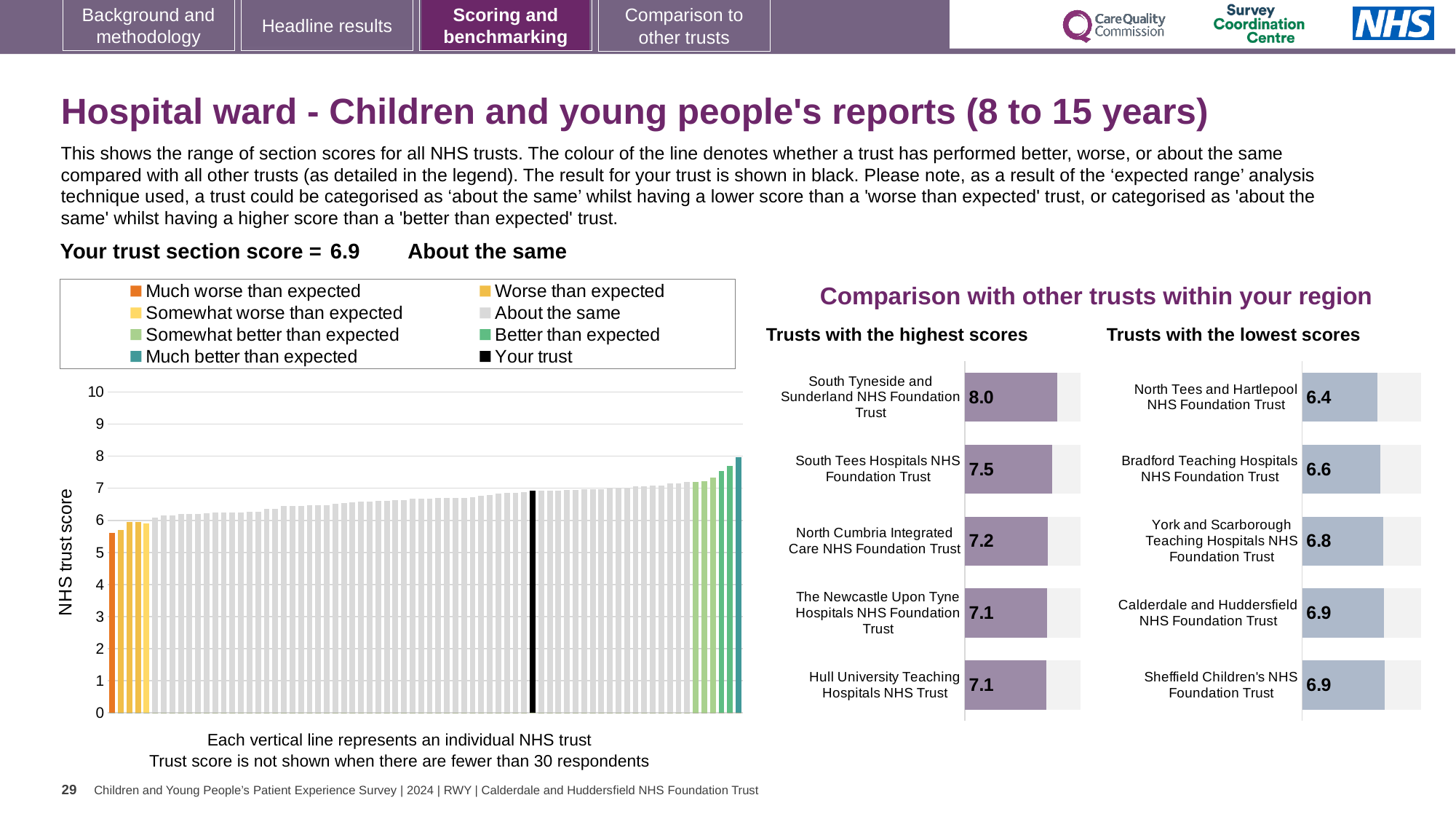
In the 'Trusts with the lowest scores' chart, which trust has the lowest score? North Tees and Hartlepool NHS Foundation Trust What kind of chart is the large chart on the left showing NHS trust scores? Bar chart In the 'Trusts with the lowest scores' chart, what is the score for Bradford Teaching Hospitals NHS Foundation Trust? 6.6 In the 'Trusts with the lowest scores' chart, which has the larger score: Bradford Teaching Hospitals NHS Foundation Trust or York and Scarborough Teaching Hospitals NHS Foundation Trust? York and Scarborough Teaching Hospitals NHS Foundation Trust In the 'Trusts with the highest scores' chart, what is the score for South Tyneside and Sunderland NHS Foundation Trust? 8.0 In the large chart on the left, is the value of the tallest bar greater or less than 7? greater In the 'Trusts with the highest scores' chart, what is the score for North Cumbria Integrated Care NHS Foundation Trust? 7.2 How many entries does the legend of the large chart on the left list? 8 In the 'Trusts with the highest scores' chart, which trust has the highest score? South Tyneside and Sunderland NHS Foundation Trust In the large chart on the left, do the bar values rise or fall from left to right along the x axis? Rise In the 'Trusts with the highest scores' chart, what is the difference between the scores of South Tyneside and Sunderland NHS Foundation Trust and South Tees Hospitals NHS Foundation Trust? 0.5 How many trusts are listed in the 'Trusts with the lowest scores' chart? 5